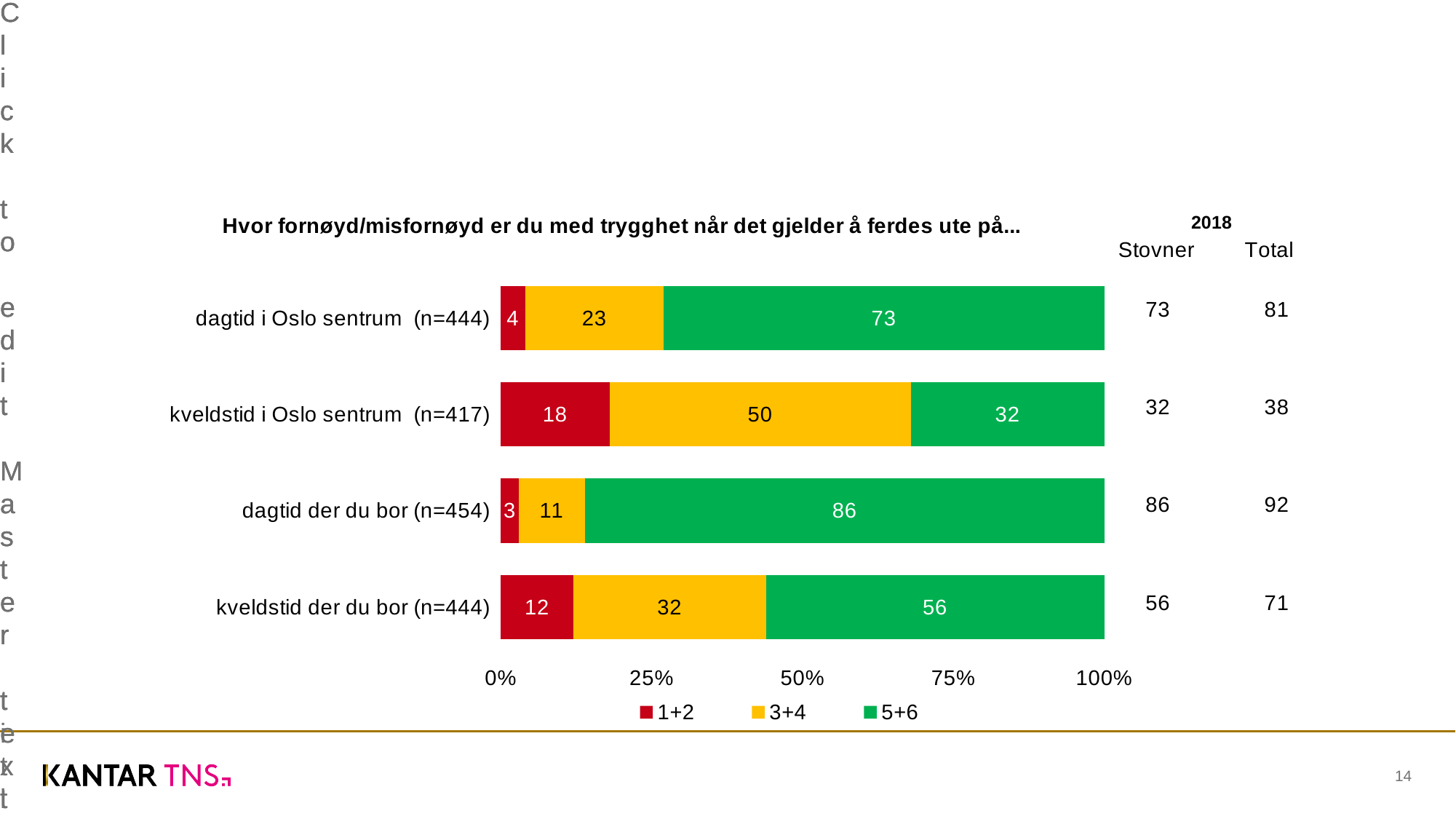
Which is larger: the 3+4 value for "kveldstid i Oslo sentrum (n=417)" or the 3+4 value for "dagtid i Oslo sentrum (n=444)"? kveldstid i Oslo sentrum (n=417) What is the value of the 1+2 series for "kveldstid i Oslo sentrum (n=417)"? 18 Which category has the lowest value for the 5+6 series? kveldstid i Oslo sentrum (n=417) What kind of chart is shown on the slide? Stacked bar chart How many series does the legend list? 3 What is the difference between the 5+6 values for "dagtid der du bor (n=454)" and "kveldstid der du bor (n=444)"? 30 What is the total of the stacked bar for "kveldstid i Oslo sentrum (n=417)"? 100 Which category has the highest value for the 5+6 series? dagtid der du bor (n=454) Which colour represents the 1+2 series in the legend? Red How many categories are shown on the chart? 4 What is the value of the 5+6 series for "dagtid i Oslo sentrum (n=444)"? 73 What is the value of the 3+4 series for "kveldstid der du bor (n=444)"? 32